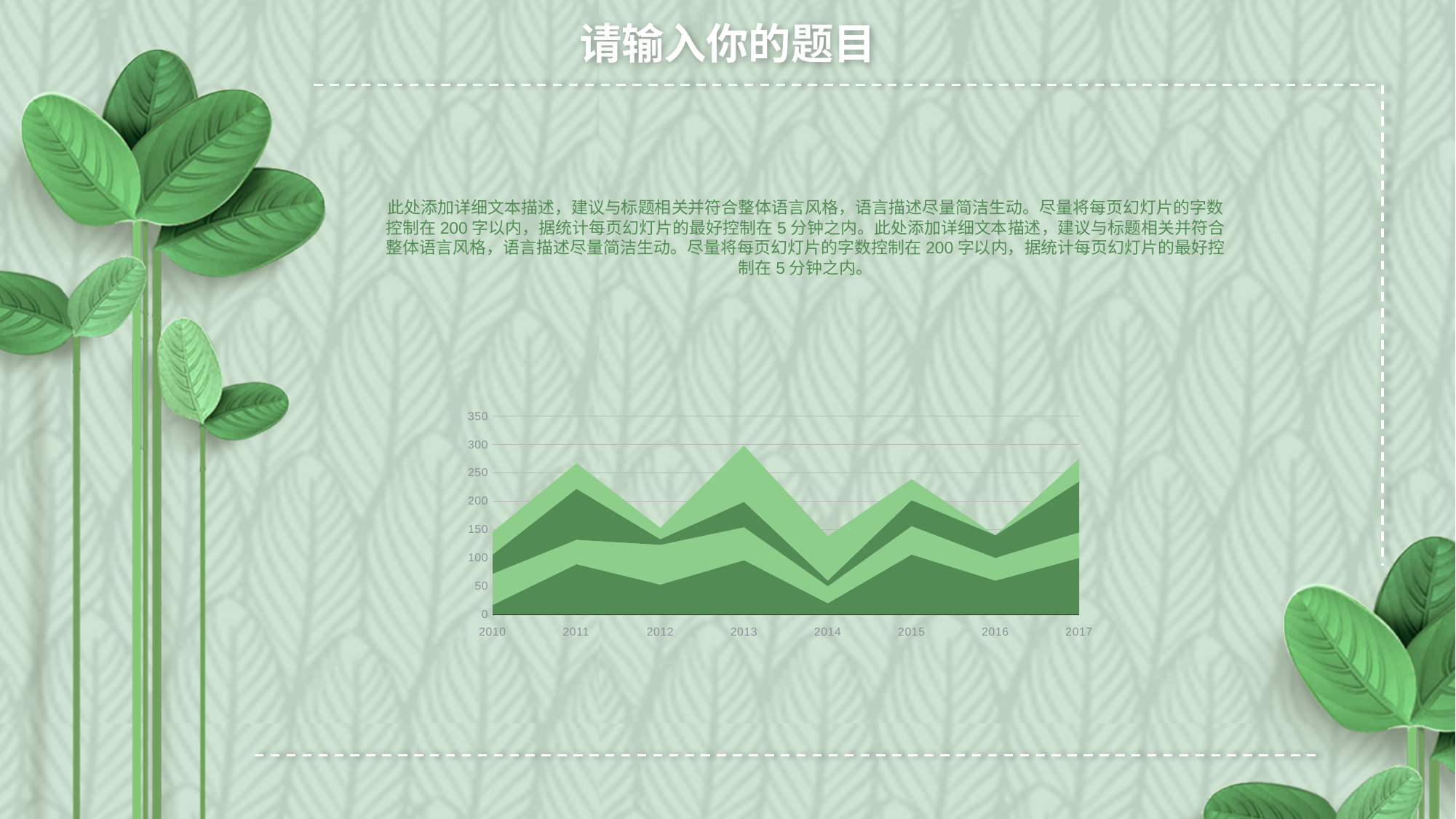
Is the top of the stacked area at 2013 greater or less than 250? greater Is the top of the stacked area at 2014 greater or less than 200? less Is the top of the stacked area at 2017 greater or less than 250? greater Does the top of the stacked area rise or fall from 2016 to 2017? rise What is the first year shown on the x axis of the chart? 2010 What kind of chart is shown on the slide? area chart How many years are shown along the x axis of the chart? 8 Does the top of the stacked area rise or fall from 2013 to 2014? fall In which year does the top of the stacked area reach its highest point? 2013 What is the last year shown on the x axis of the chart? 2017